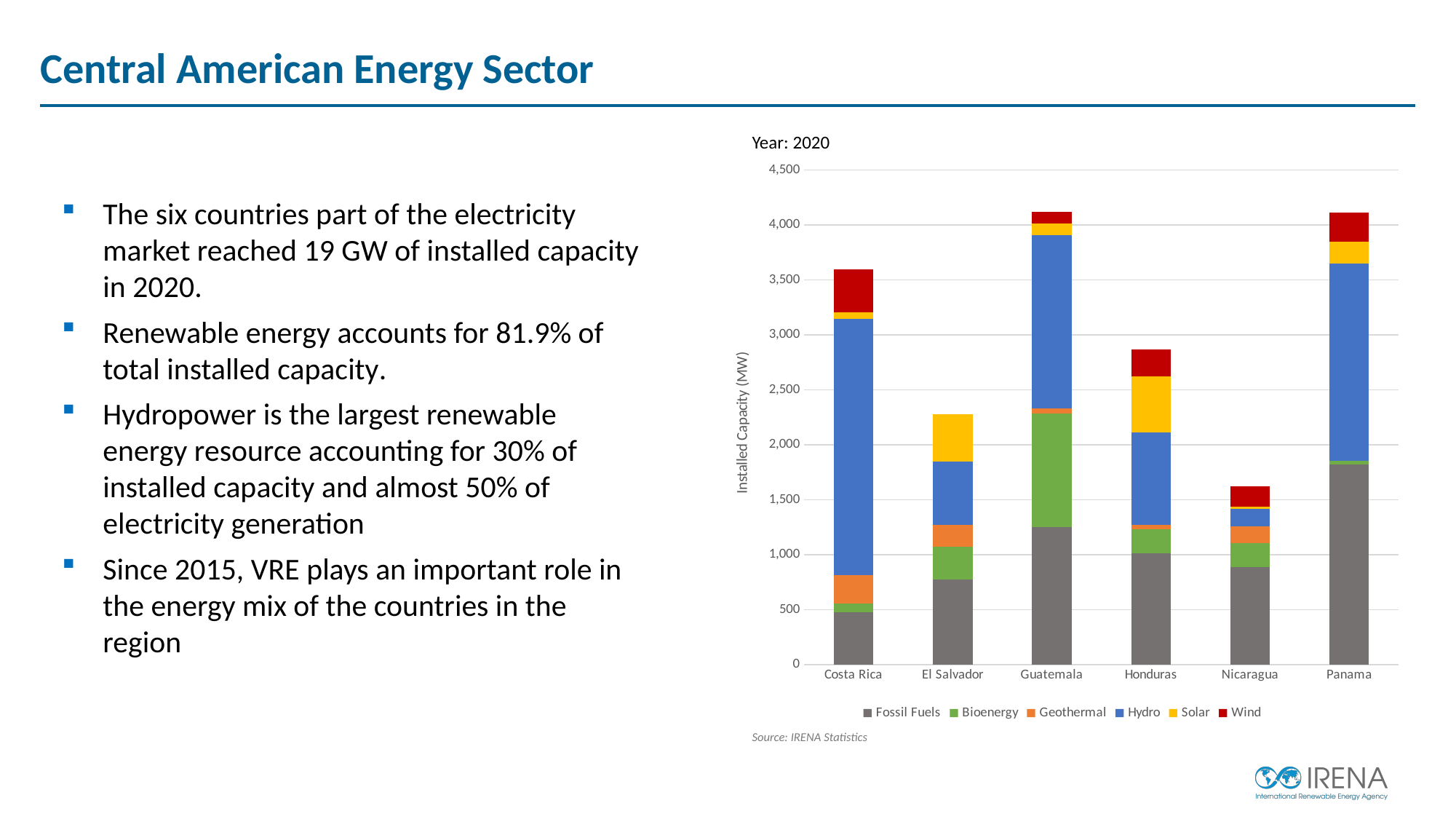
How many series does the chart legend list? 6 Is the total installed capacity for Honduras greater or less than 2,500 MW? greater Which has a larger total installed capacity, Costa Rica or El Salvador? Costa Rica Which country has the lowest total installed capacity in the chart? Nicaragua What is the label of the y axis of the chart? Installed Capacity (MW) Is the total installed capacity for El Salvador greater or less than 2,500 MW? less How many countries are shown on the x axis of the chart? 6 Is the total installed capacity for Costa Rica greater or less than 3,500 MW? greater What kind of chart is shown on the slide? Stacked bar chart Which has a larger Bioenergy capacity, Guatemala or Costa Rica? Guatemala